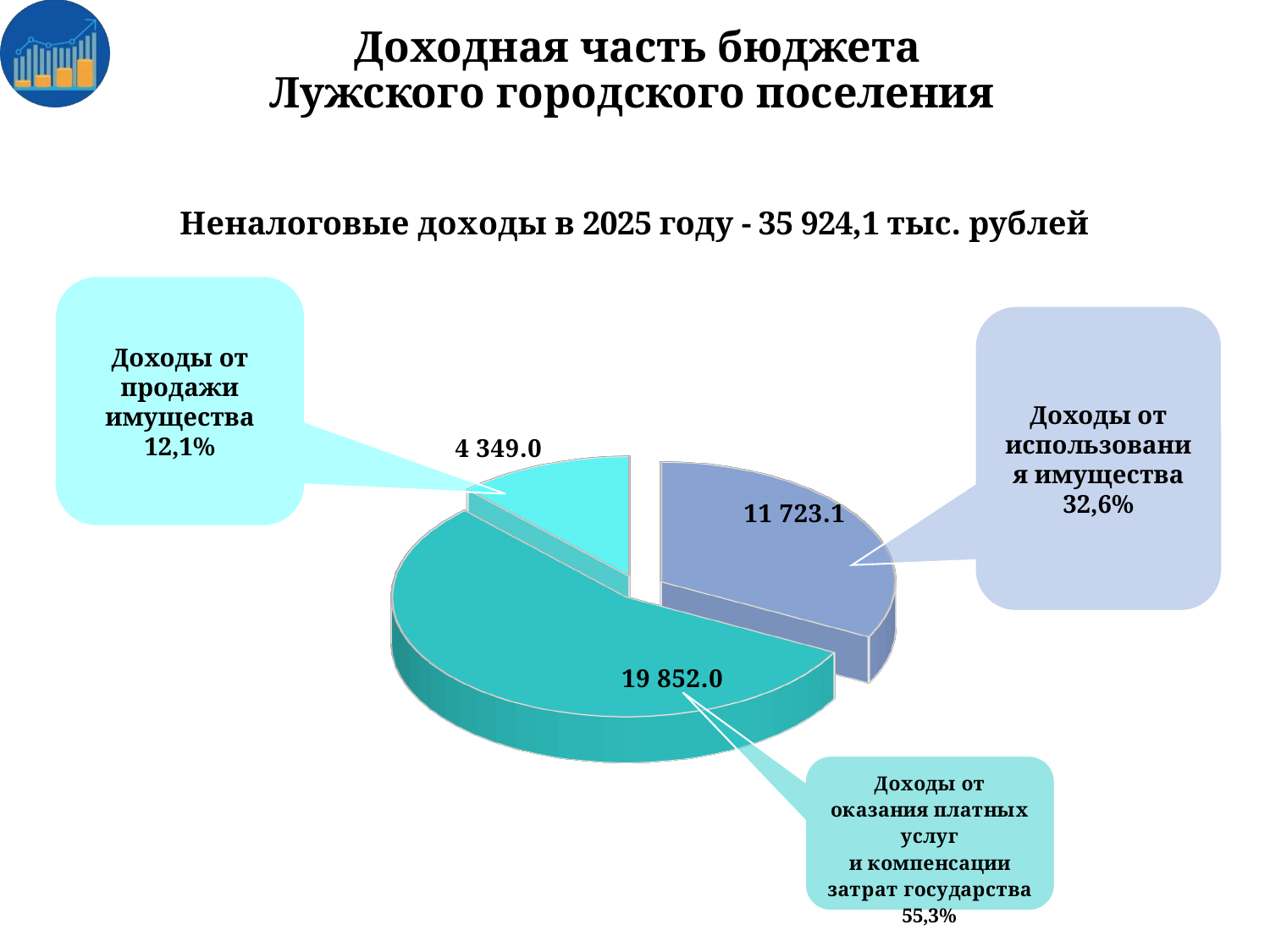
What share of the pie does "Доходы от продажи имущества" represent? 12,1% Which category has the largest slice of the pie? Доходы от оказания платных услуг и компенсации затрат государства What is the value of the slice for "Доходы от оказания платных услуг и компенсации затрат государства"? 19 852.0 What is the difference between the values for "Доходы от оказания платных услуг и компенсации затрат государства" and "Доходы от использования имущества"? 8 128.9 What share of the pie does "Доходы от использования имущества" represent? 32,6% What kind of chart is shown on the slide? pie chart Which category has the smallest slice of the pie? Доходы от продажи имущества What is the value of the slice for "Доходы от продажи имущества"? 4 349.0 Which is larger: the slice for "Доходы от использования имущества" or the slice for "Доходы от продажи имущества"? Доходы от использования имущества What is the value of the slice for "Доходы от использования имущества"? 11 723.1 How many slices does the pie chart have? 3 What total amount of non-tax revenue for 2025 is stated above the chart? 35 924,1 тыс. рублей